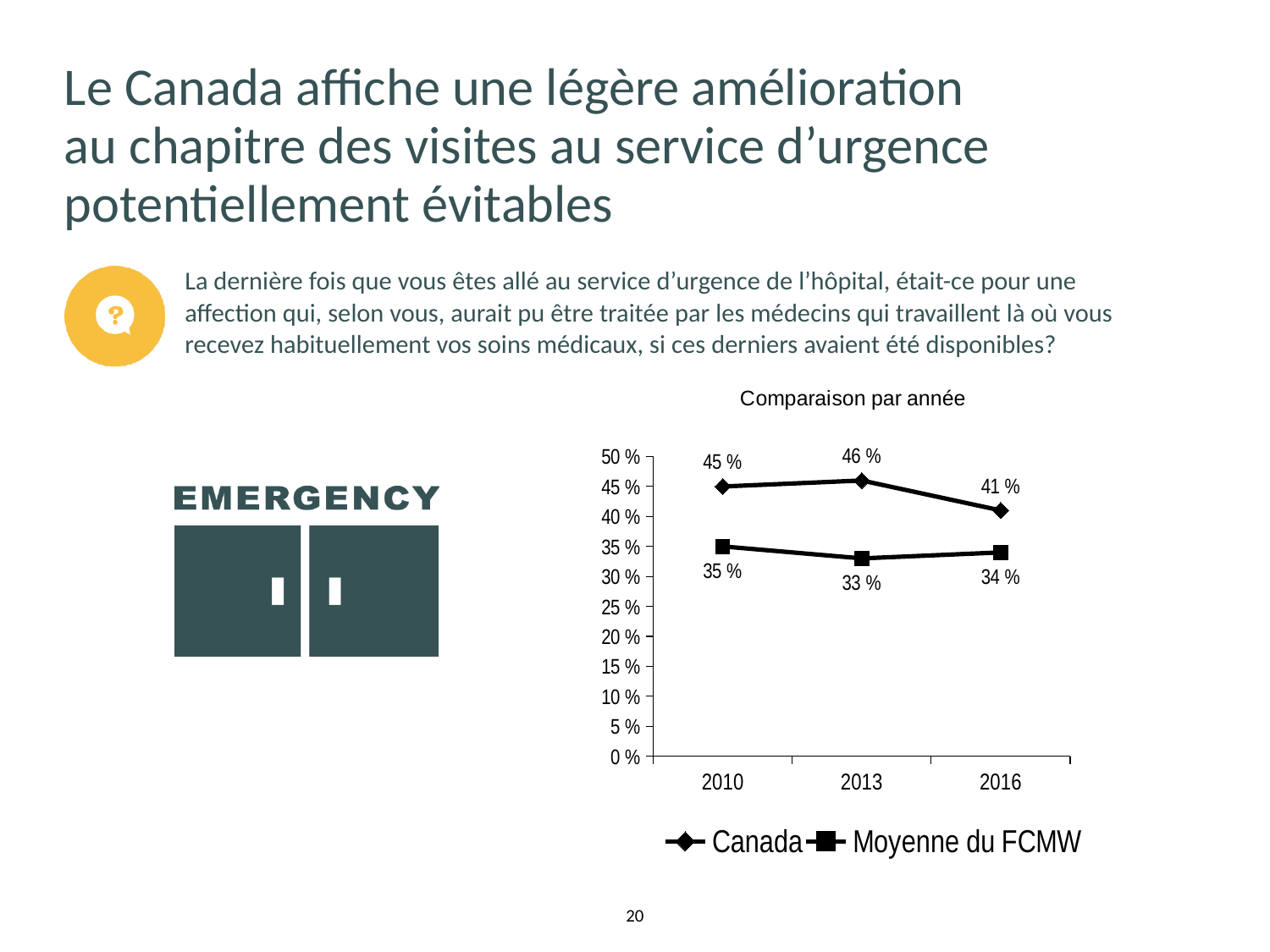
Is the value for Canada in 2010 greater or less than 40 %? greater What is the value for Canada in 2010? 45 % What is the value for Moyenne du FCMW in 2013? 33 % In which year is the Canada value highest? 2013 How many series does the legend list? 2 What is the title of the chart? Comparaison par année In which year is the Moyenne du FCMW value lowest? 2013 What is the value for Canada in 2016? 41 % What kind of chart is shown? line chart What is the difference between Canada and Moyenne du FCMW in 2013? 13 % How many years are shown on the x axis? 3 Which is larger in 2016, Canada or Moyenne du FCMW? Canada